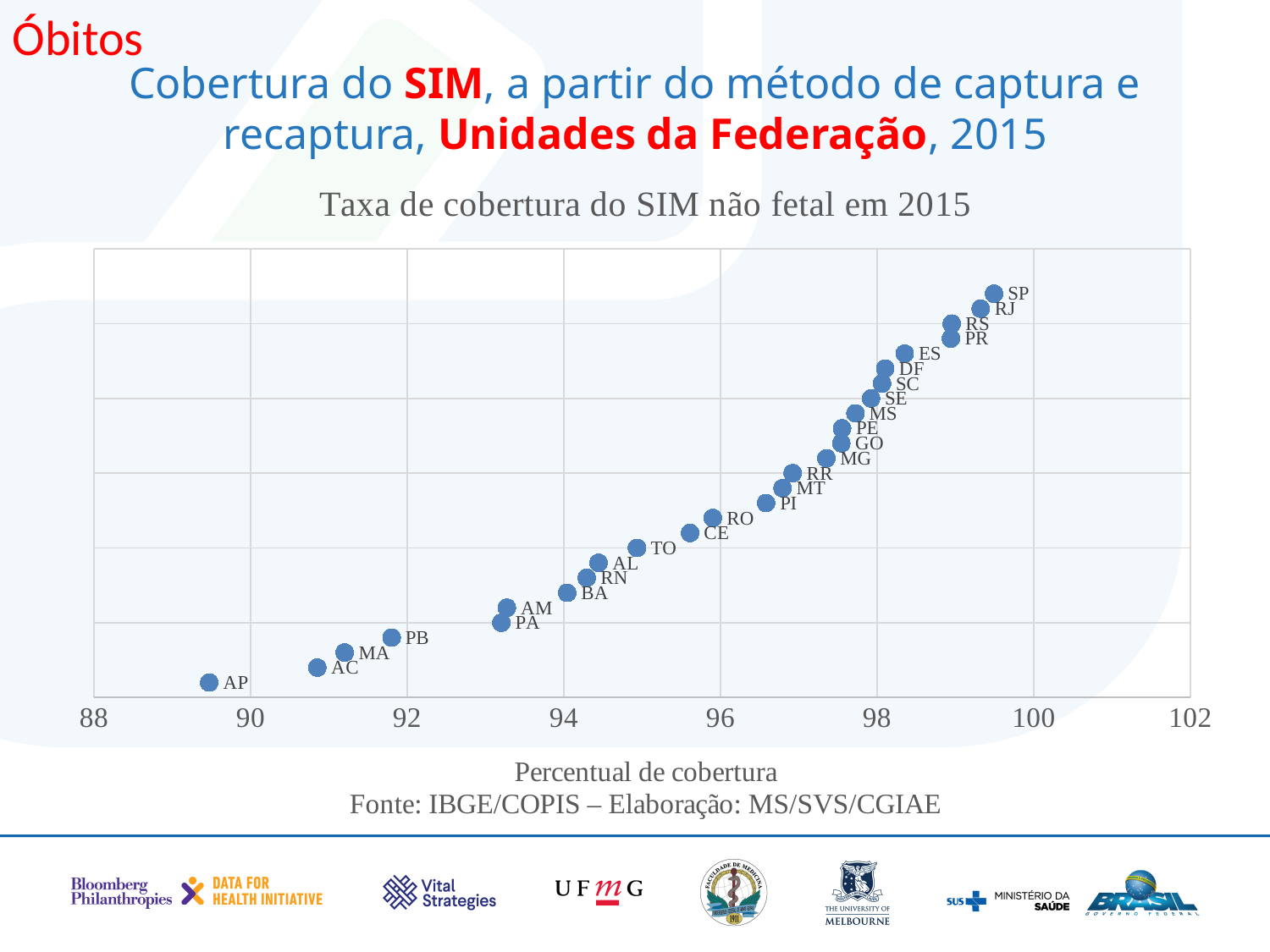
Is the value for AP greater or less than 90? less How many states (points) are plotted in the chart? 27 Which has a higher coverage rate, PB or AC? PB Is the value for PB greater or less than 92? less What is the title of the chart? Taxa de cobertura do SIM não fetal em 2015 Which has a higher coverage rate, BA or CE? CE What kind of chart is shown on the slide? scatter plot Is the value for TO greater or less than 96? less Which state has the lowest SIM coverage rate in the chart? AP Which state has the highest SIM coverage rate in the chart? SP